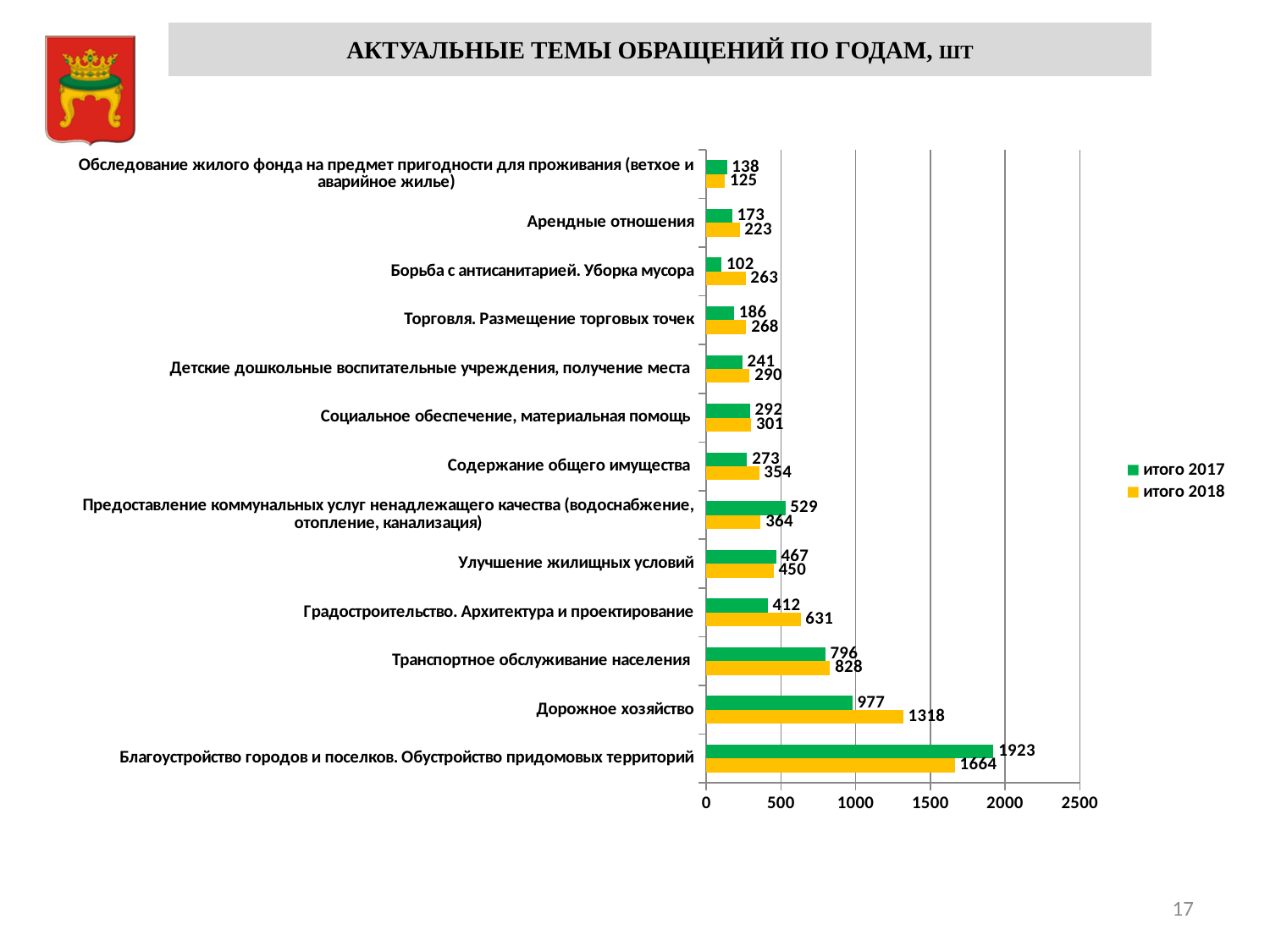
Which category has the lowest value in the 'итого 2018' series? Обследование жилого фонда на предмет пригодности для проживания (ветхое и аварийное жилье) What is the value for 'Транспортное обслуживание населения' in the 'итого 2017' series? 796 Which category has the lowest value in the 'итого 2017' series? Борьба с антисанитарией. Уборка мусора Which category has the highest value in the 'итого 2017' series? Благоустройство городов и поселков. Обустройство придомовых территорий How many series does the legend list? 2 How many categories are shown on the chart? 13 What is the difference between the 'итого 2017' and 'итого 2018' values for 'Благоустройство городов и поселков. Обустройство придомовых территорий'? 259 What is the difference between the 'итого 2018' and 'итого 2017' values for 'Градостроительство. Архитектура и проектирование'? 219 For 'Предоставление коммунальных услуг ненадлежащего качества (водоснабжение, отопление, канализация)', which series has the larger value, 'итого 2017' or 'итого 2018'? итого 2017 What is the value for 'Дорожное хозяйство' in the 'итого 2018' series? 1318 What colour represents the 'итого 2018' series? Yellow What type of chart is shown on the slide? Bar chart